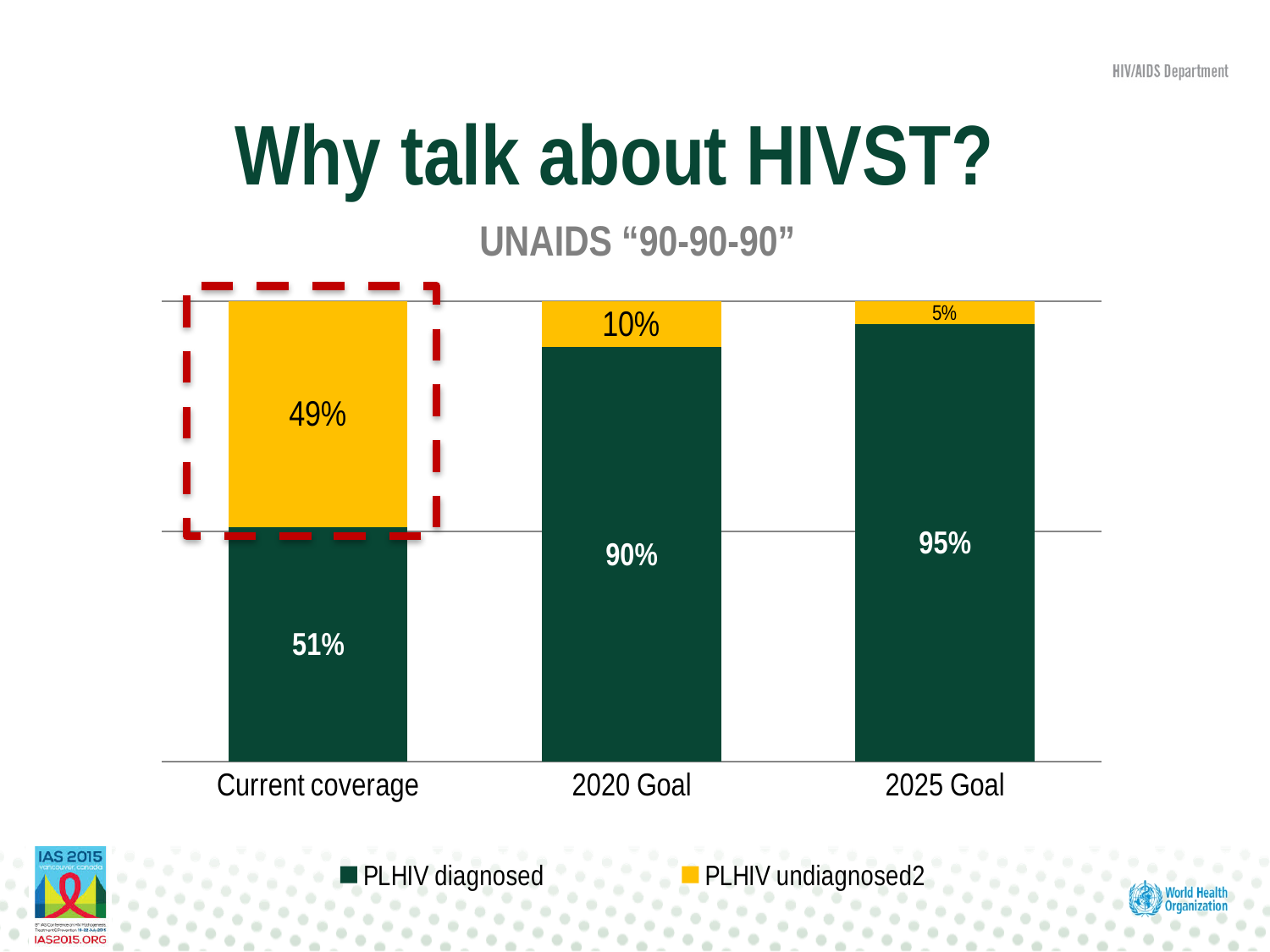
Which is larger: PLHIV undiagnosed2 for Current coverage or for 2020 Goal? Current coverage What is the difference between the PLHIV diagnosed values for 2020 Goal and Current coverage? 39% What is the value for PLHIV diagnosed in the 2020 Goal bar? 90% How many series does the legend list? 2 What is the value for PLHIV undiagnosed2 in the 2025 Goal bar? 5% What kind of chart is shown? Stacked bar chart What is the total of the stacked bar for 2020 Goal? 100% What is the value for PLHIV diagnosed in the Current coverage bar? 51% Which category has the highest PLHIV diagnosed value? 2025 Goal Which category has the lowest PLHIV undiagnosed2 value? 2025 Goal What is the value for PLHIV undiagnosed2 in the Current coverage bar? 49% How many categories are shown on the x axis? 3